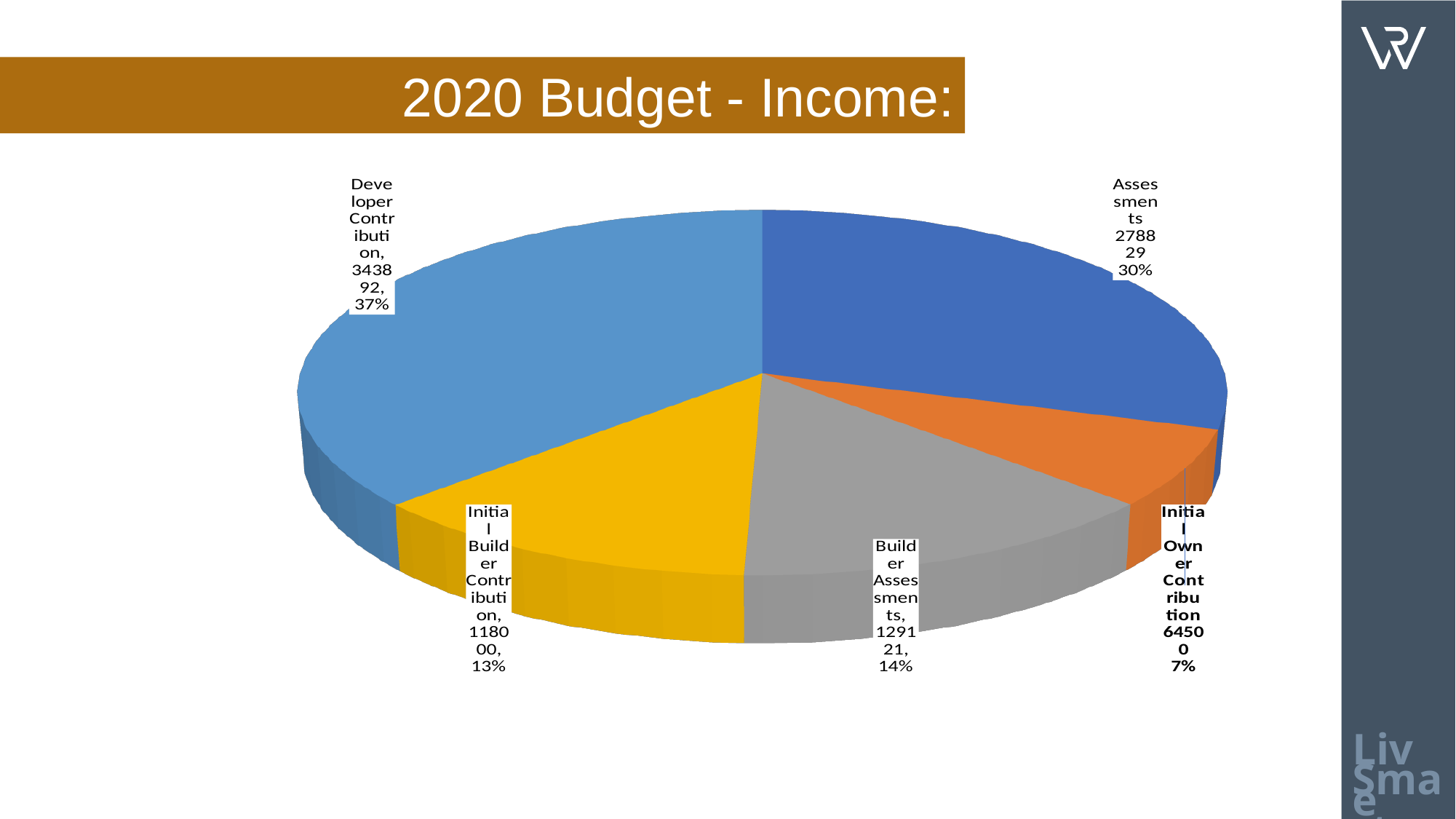
Which category has the smallest slice of the pie? Initial Owner Contribution What is the value shown for Assessments? 278829 Which category has the largest slice of the pie? Developer Contribution What is the value shown for Builder Assessments? 129121 What kind of chart is shown on the slide? pie chart What percentage share of the pie does Developer Contribution have? 37% What is the value shown for Developer Contribution? 343892 What is the value shown for Initial Builder Contribution? 118000 What percentage share of the pie does Initial Owner Contribution have? 7% How many slices does the pie chart have? 5 What is the difference between the Assessments value and the Builder Assessments value? 149708 What is the title of the chart slide? 2020 Budget - Income: